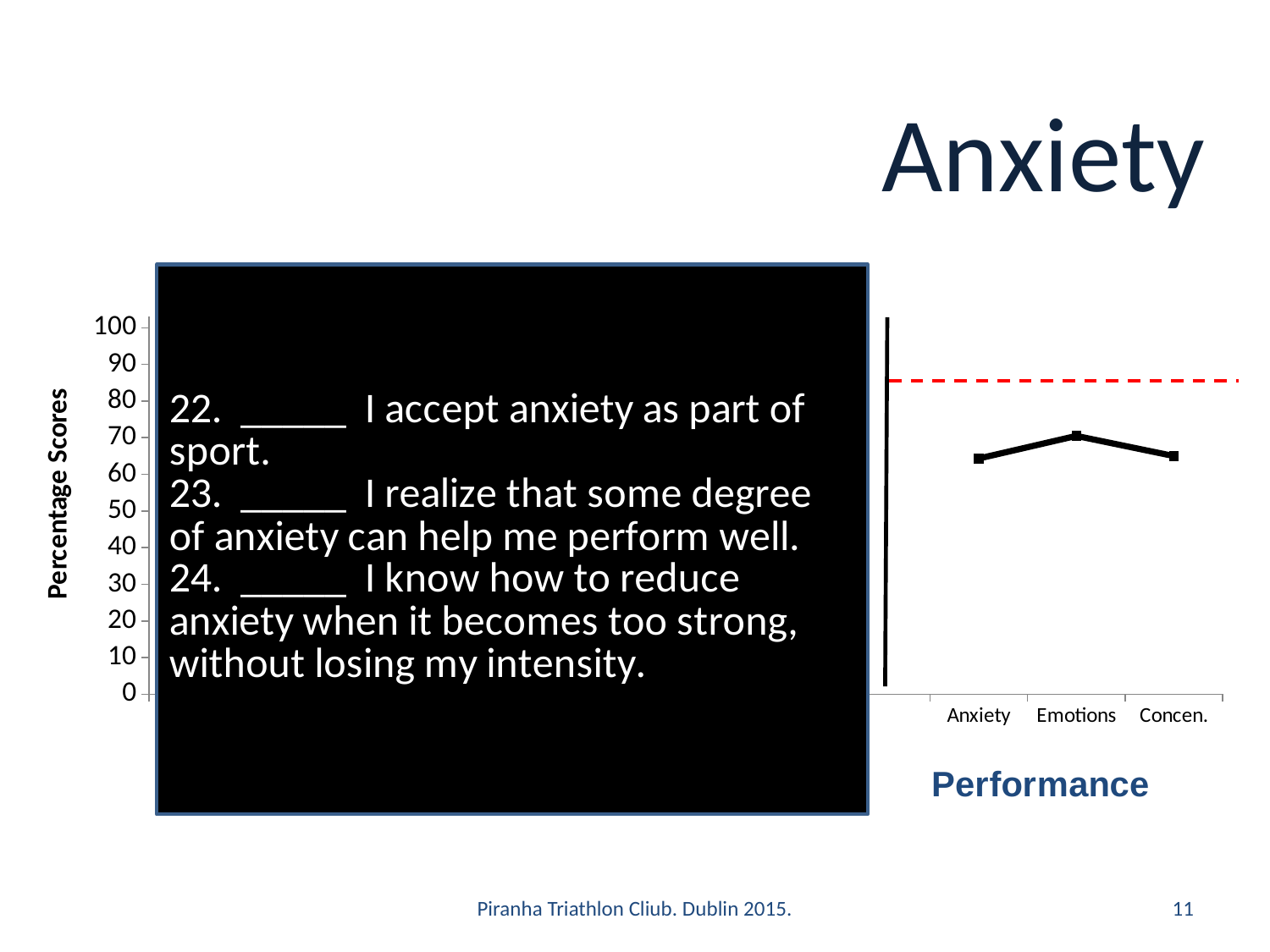
Is the value for Anxiety greater or less than 50? greater What is the label of the vertical axis of the chart? Percentage Scores Does the line rise or fall from Anxiety to Emotions? rise Which is larger, the value for Emotions or the value for Anxiety? Emotions Among the visible categories Anxiety, Emotions and Concen., which has the highest value? Emotions Is the value for Concen. greater or less than 80? less What kind of chart is shown on the slide? line chart Does the line rise or fall from Emotions to Concen.? fall Is the value for Emotions greater or less than 60? greater Is the red dashed horizontal line above or below the 80 mark on the vertical axis? above